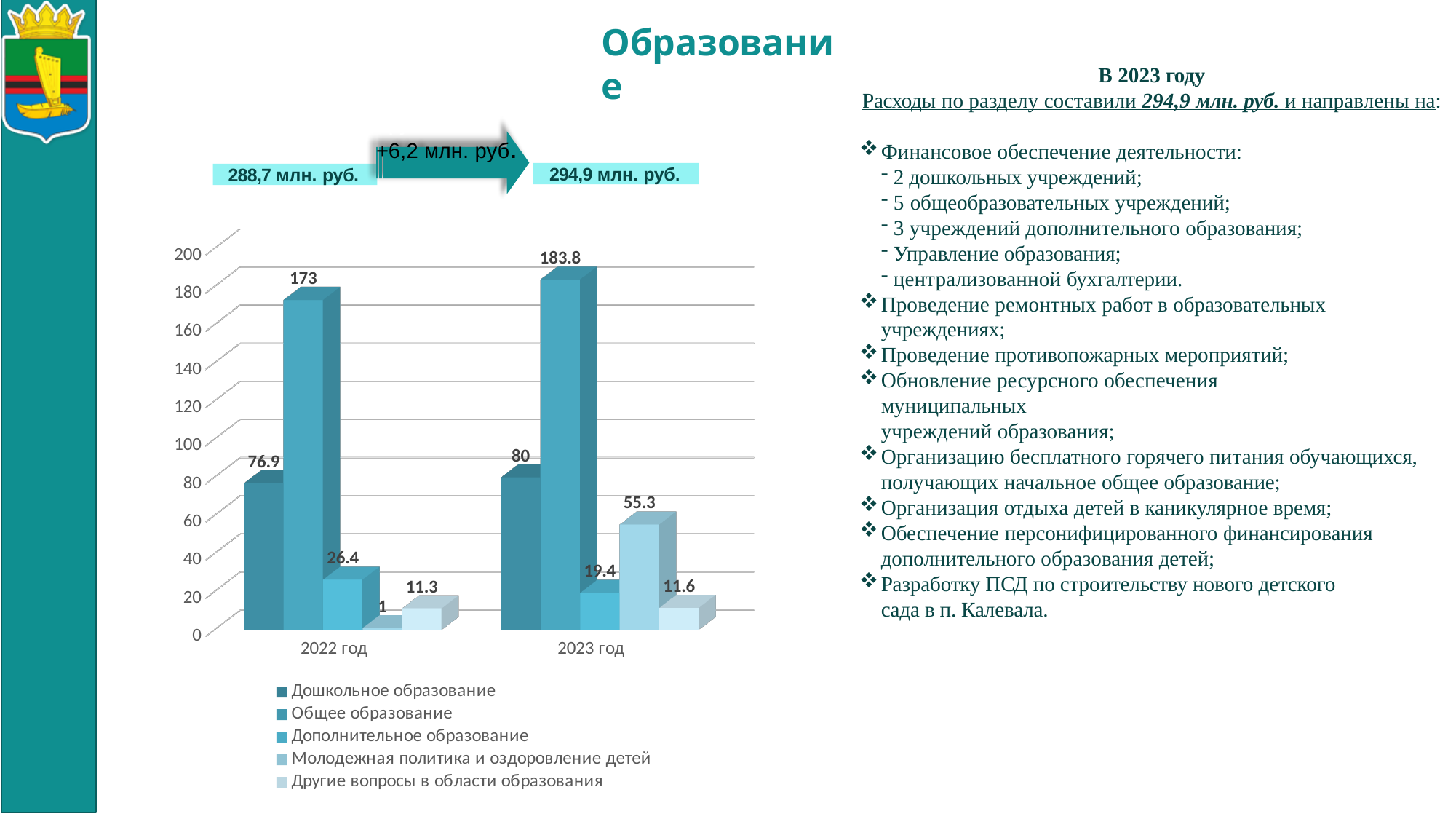
Which is larger: Дополнительное образование in 2022 год or in 2023 год? 2022 год What is the value for Молодежная политика и оздоровление детей in 2023 год? 55.3 What is the value for Дополнительное образование in 2022 год? 26.4 What total amount in млн. руб. is shown in the box above the chart for 2023? 294,9 млн. руб. What is the value for Дошкольное образование in 2022 год? 76.9 By how much did Общее образование change from 2022 год to 2023 год? 10.8 What is the value for Общее образование in 2023 год? 183.8 How many series does the chart legend list? 5 Does the value for Дошкольное образование rise or fall from 2022 год to 2023 год? rise Which series has the highest value in 2023 год? Общее образование What kind of chart is shown on the slide? bar chart How many year categories are shown on the x axis of the chart? 2